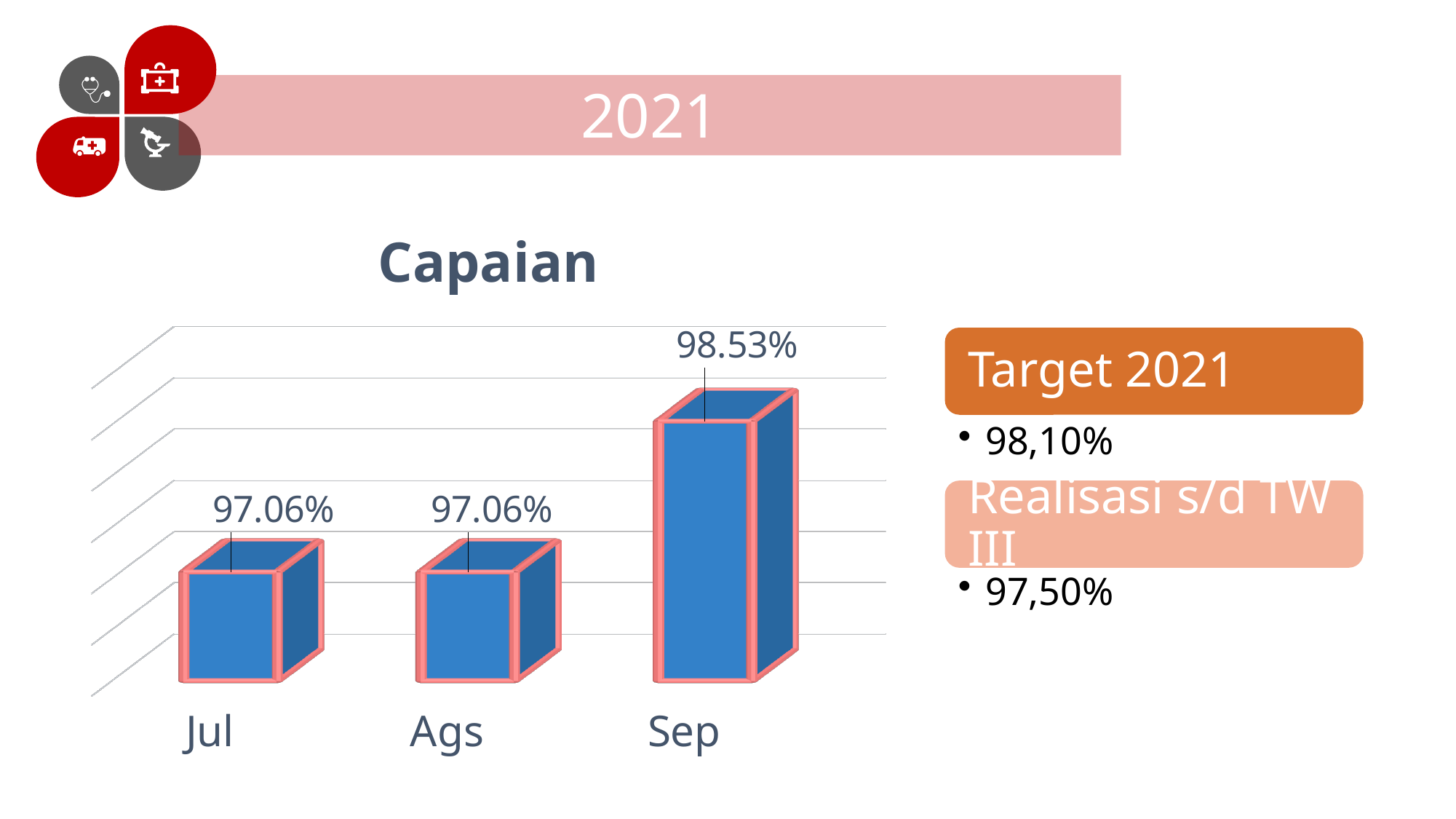
Which month has the highest value in the Capaian chart? Sep How many months are shown on the x axis of the Capaian chart? 3 What kind of chart is the Capaian chart? bar chart What is the value for Ags in the Capaian chart? 97.06% Which is larger in the Capaian chart, the value for Sep or the value for Ags? Sep Are the values for Jul and Ags in the Capaian chart the same or different? the same Do the values in the Capaian chart rise or fall from Jul to Sep? rise What colour are the bars in the Capaian chart? blue What is the title of the chart on the slide? Capaian What is the value for Sep in the Capaian chart? 98.53% What is the value for Jul in the Capaian chart? 97.06% What is the difference between the values for Sep and Jul in the Capaian chart? 1.47%